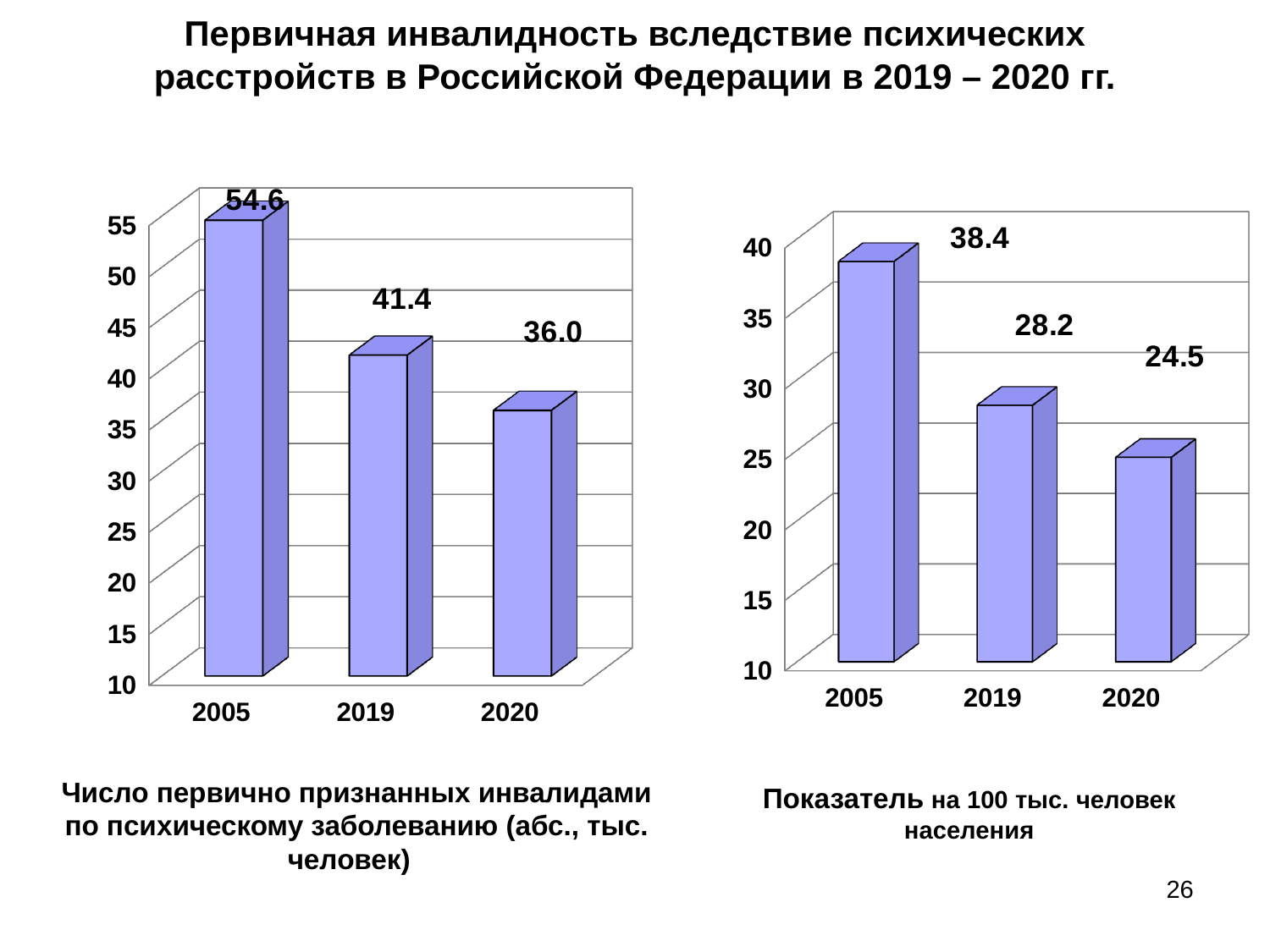
What kind of chart is the right chart? bar chart In the left chart, what is the difference between the values for 2005 and 2020? 18.6 In the left chart, do the values rise or fall from 2005 to 2020? fall In the right chart, which is larger: the value for 2005 or the value for 2019? 2005 In the right chart, which year has the lowest value? 2020 In the left chart, which year has the highest value? 2005 In the right chart (rate per 100 thousand population), what is the value for 2020? 24.5 How many bars does the left chart have? 3 In the left chart (number of people first recognised as disabled, thousands), what is the value for 2020? 36.0 In the right chart (rate per 100 thousand population), what is the value for 2019? 28.2 In the left chart (number of people first recognised as disabled, thousands), what is the value for 2005? 54.6 In the right chart, what is the difference between the values for 2019 and 2020? 3.7